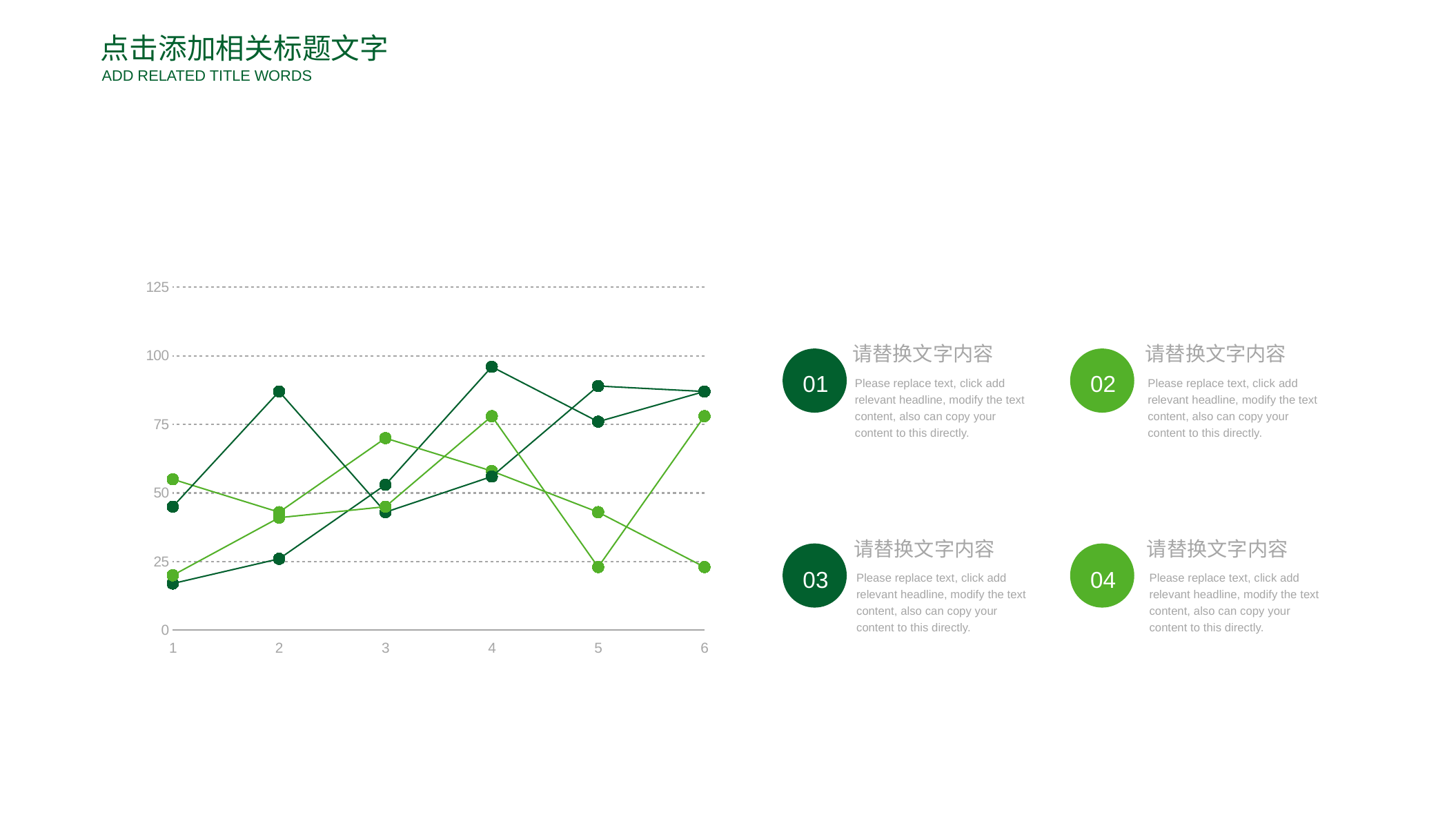
Is the highest point plotted at x = 2 greater or less than 75? greater What is the highest value shown on the y axis of the chart? 125 At which x-axis value does the single highest point on the chart occur? 4 Is the lowest point plotted at x = 5 greater or less than 50? less Is the highest point plotted at x = 1 greater or less than 75? less How many points are labelled along the x axis of the chart? 6 What is the first label on the x axis of the chart? 1 What kind of chart is shown on the slide? line chart